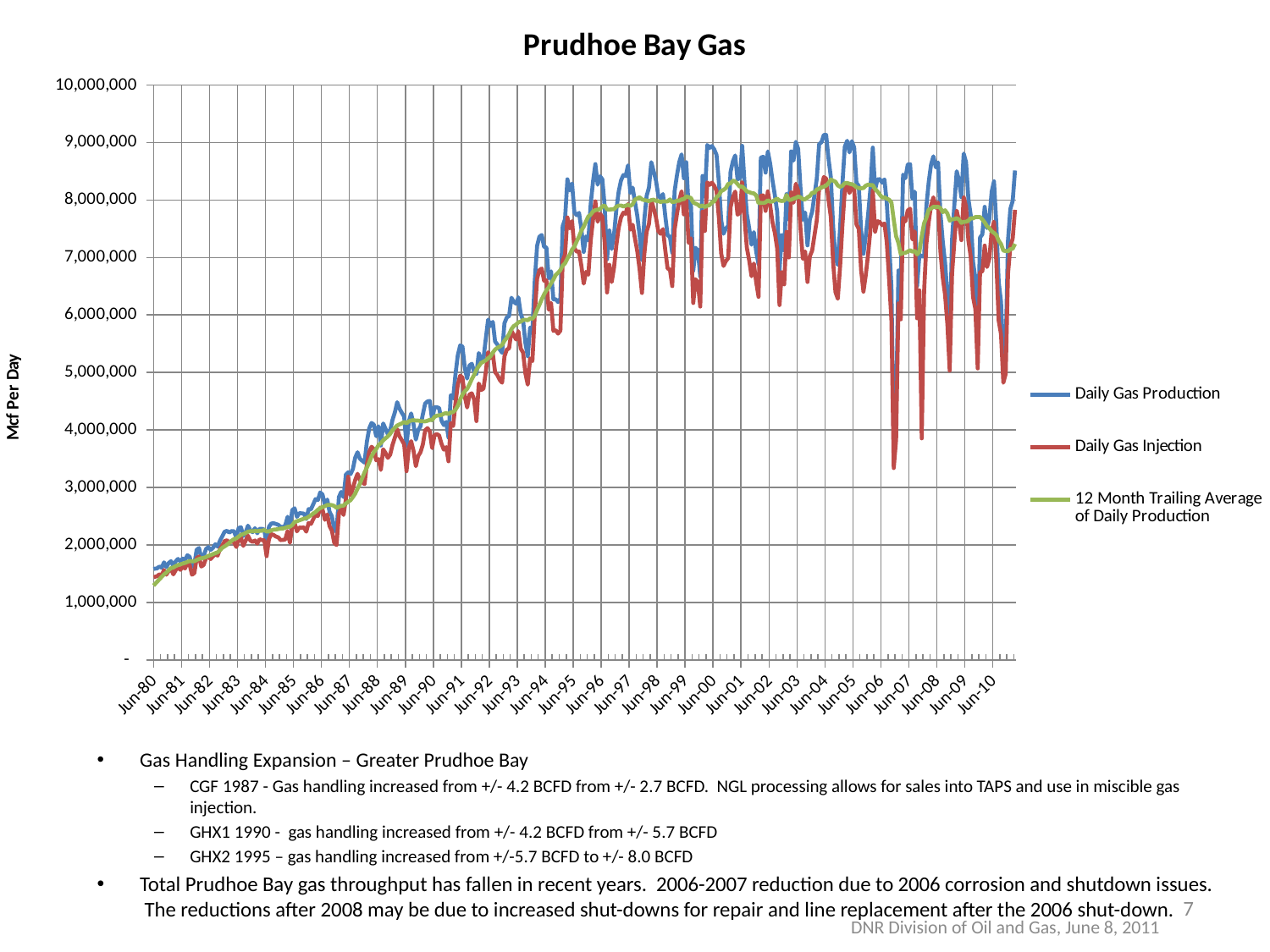
Is the Daily Gas Production value at Jun-85 greater or less than 2,000,000? greater What is the title of the chart? Prudhoe Bay Gas Is the 12 Month Trailing Average of Daily Production at Jun-88 greater or less than 5,000,000? less Is the Daily Gas Production value at Jun-80 greater or less than 2,000,000? less How many series does the chart legend list? 3 What kind of chart is shown on the slide? line chart Does Daily Gas Production generally rise or fall between Jun-80 and Jun-95? rise Which series is higher at Jun-80, Daily Gas Production or Daily Gas Injection? Daily Gas Production What is the label on the vertical axis of the chart? Mcf Per Day What is the highest value shown on the vertical axis? 10,000,000